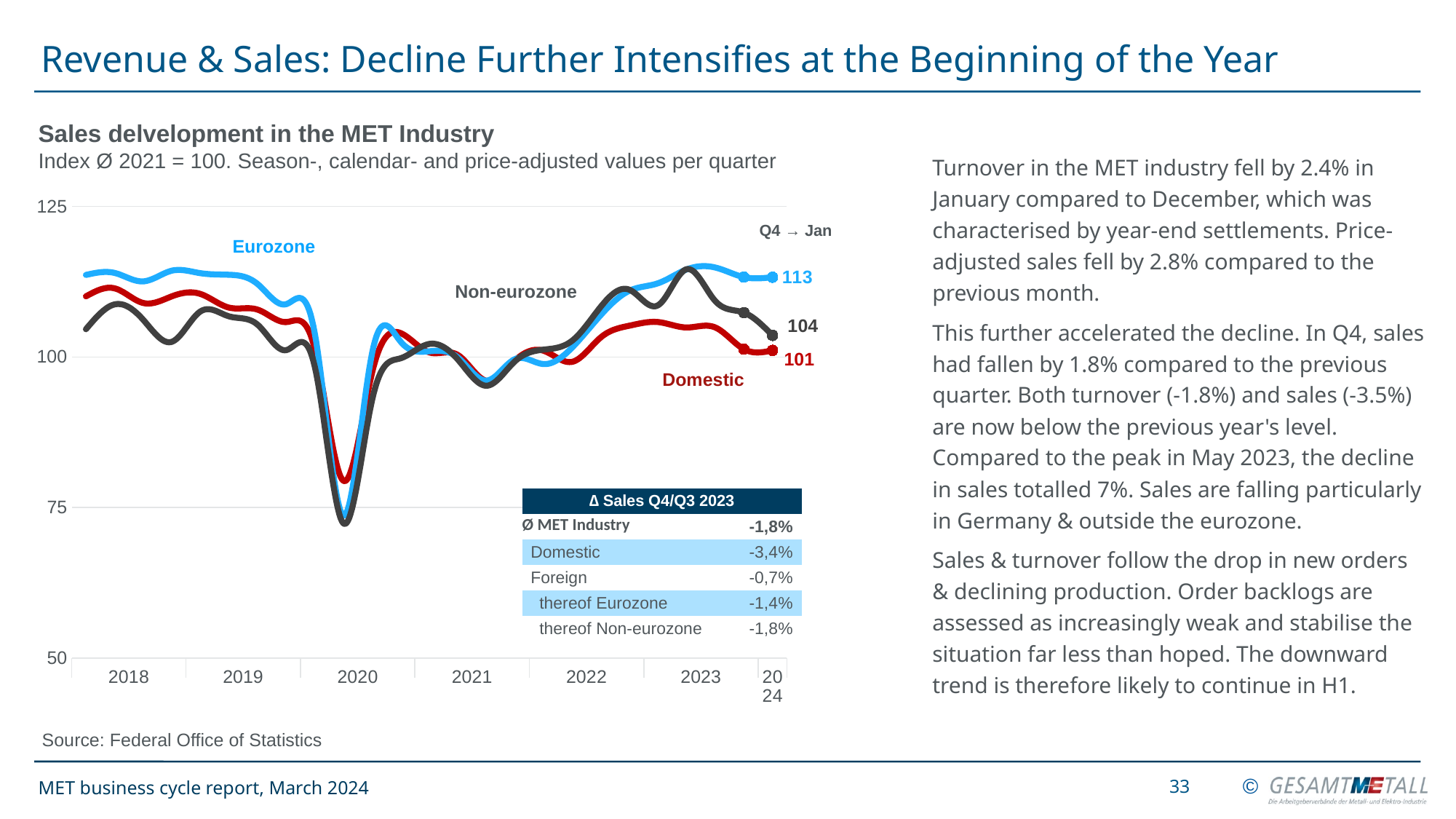
What is the difference between the latest Eurozone value and the latest Domestic value? 12 Does the Domestic line rise or fall from its 2023 peak to Jan 2024? fall What is the latest (Jan) index value of the Eurozone line? 113 What is the latest (Jan) index value of the Non-eurozone line? 104 What is the latest (Jan) index value of the Domestic line? 101 At the end of the chart (Jan), which is larger: the Non-eurozone value or the Domestic value? Non-eurozone Is the lowest point of the Non-eurozone line in 2020 greater or less than 75? less What type of chart is used to show sales development in the MET Industry? line chart How many series are plotted in the sales development chart? 3 Which series has the highest index value at the end of the chart (Jan)? Eurozone What is the difference between the latest Eurozone value and the latest Non-eurozone value? 9 Which series has the lowest index value at the end of the chart (Jan)? Domestic